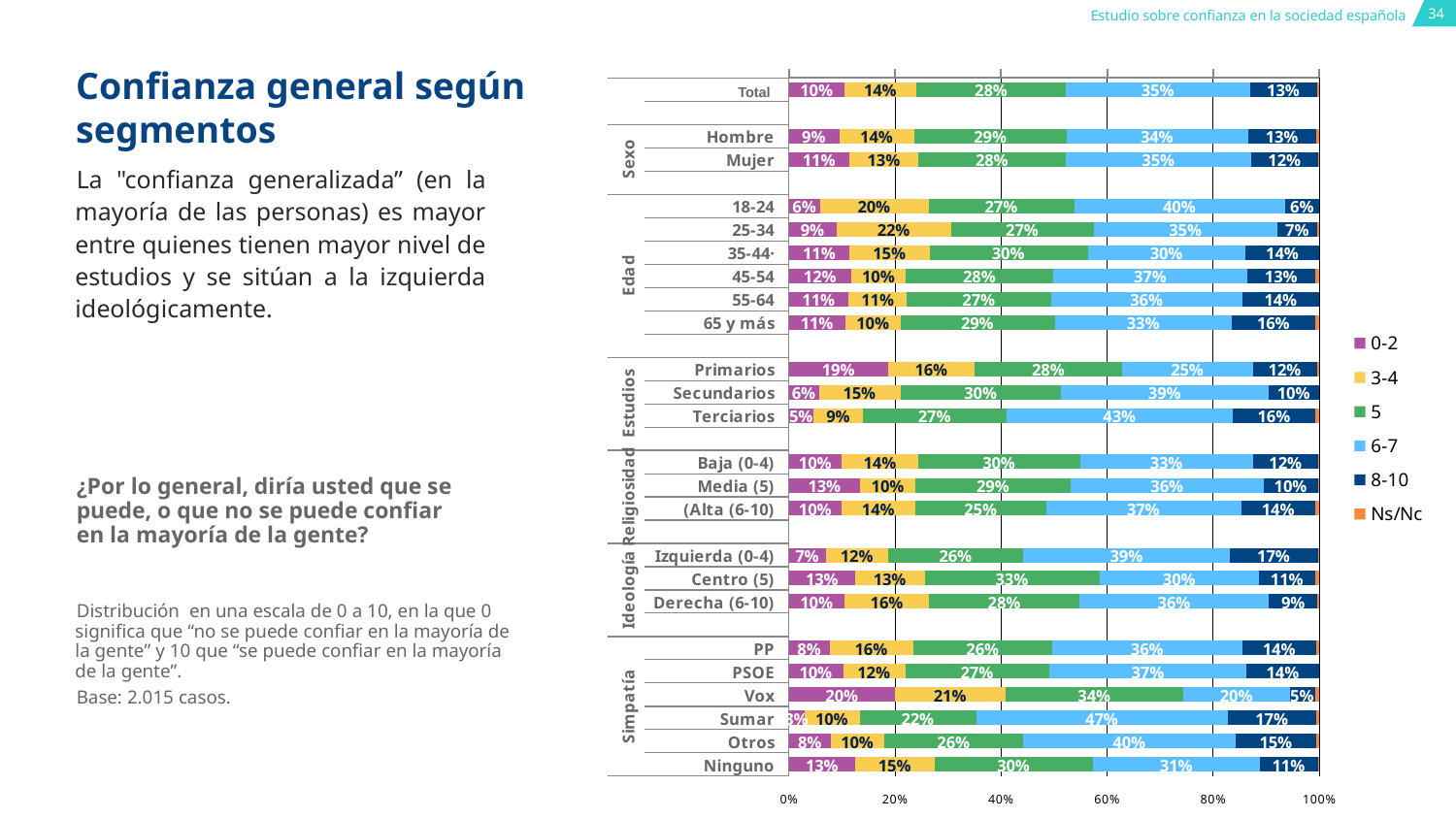
How many category bars are plotted in the chart? 24 What are the legend entries of the chart? 0-2, 3-4, 5, 6-7, 8-10, Ns/Nc What is the value of the 6-7 segment for Terciarios? 43% What is the difference between the 6-7 values for Terciarios and Primarios? 18 percentage points Which category has the highest value in the 6-7 segment? Sumar What is the value of the 6-7 segment for the Total bar? 35% How many series does the legend list? 6 What kind of chart is shown on the slide? Stacked bar chart Which category has the lowest value in the 8-10 segment? Vox What is the value of the 0-2 segment for Vox? 20% Which has a larger 8-10 value, Izquierda (0-4) or Derecha (6-10)? Izquierda (0-4) What is the value of the 3-4 segment for the 18-24 age group? 20%